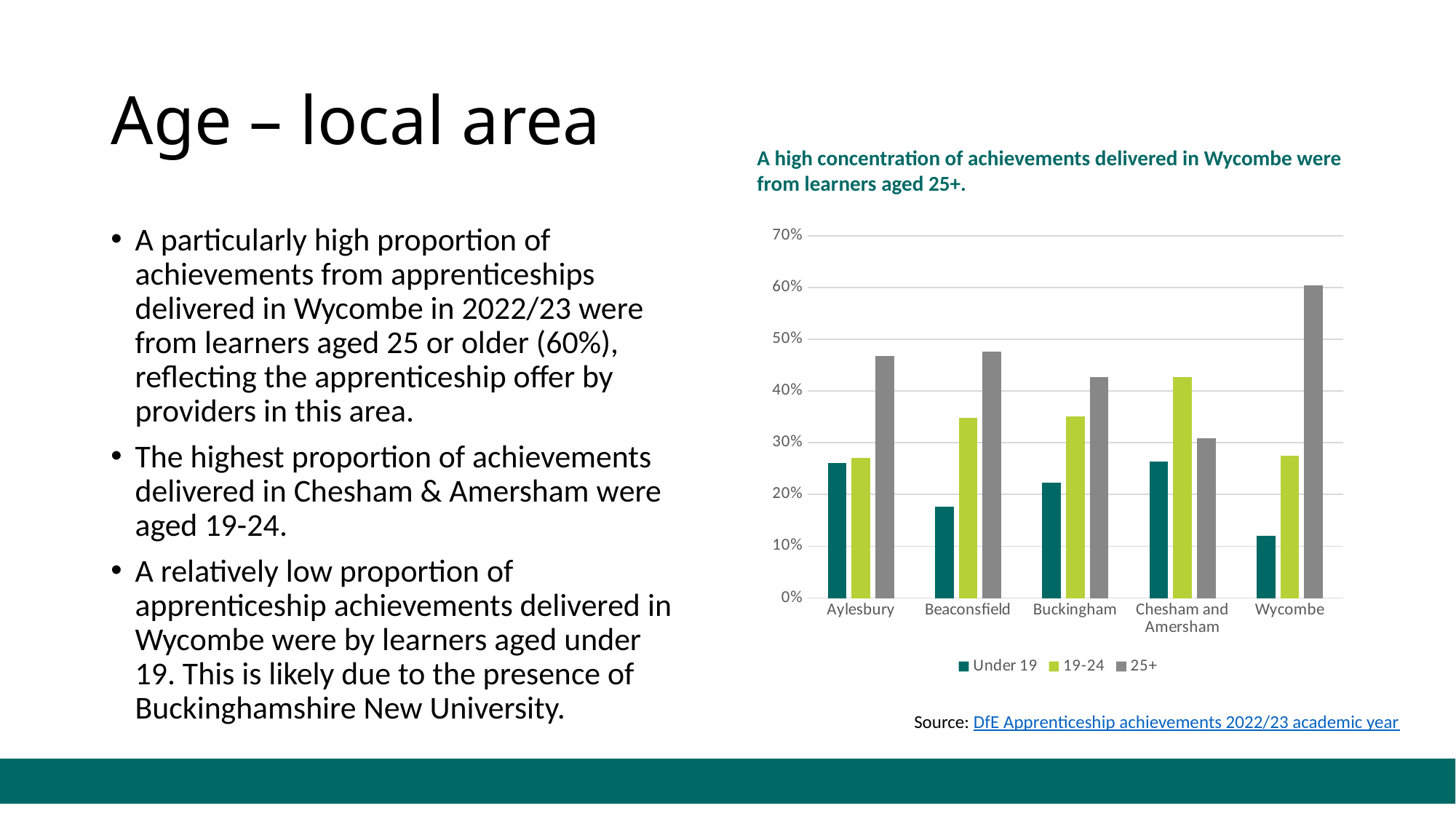
Is the Under 19 value for Beaconsfield greater or less than 20%? less In Chesham and Amersham, which is larger: the 19-24 value or the 25+ value? 19-24 How many local areas are shown on the x axis of the chart? 5 How many series does the chart's legend list? 3 Which local area has the lowest value for the Under 19 series? Wycombe Which is larger: the Under 19 value for Aylesbury or the Under 19 value for Beaconsfield? Aylesbury Which local area has the highest value for the 19-24 series? Chesham and Amersham Is the 25+ value for Buckingham greater or less than 40%? greater What are the three series listed in the chart's legend? Under 19, 19-24, 25+ What kind of chart is shown on the slide? Bar chart Which local area has the highest value for the 25+ series? Wycombe Is the 25+ value for Wycombe greater or less than 50%? greater